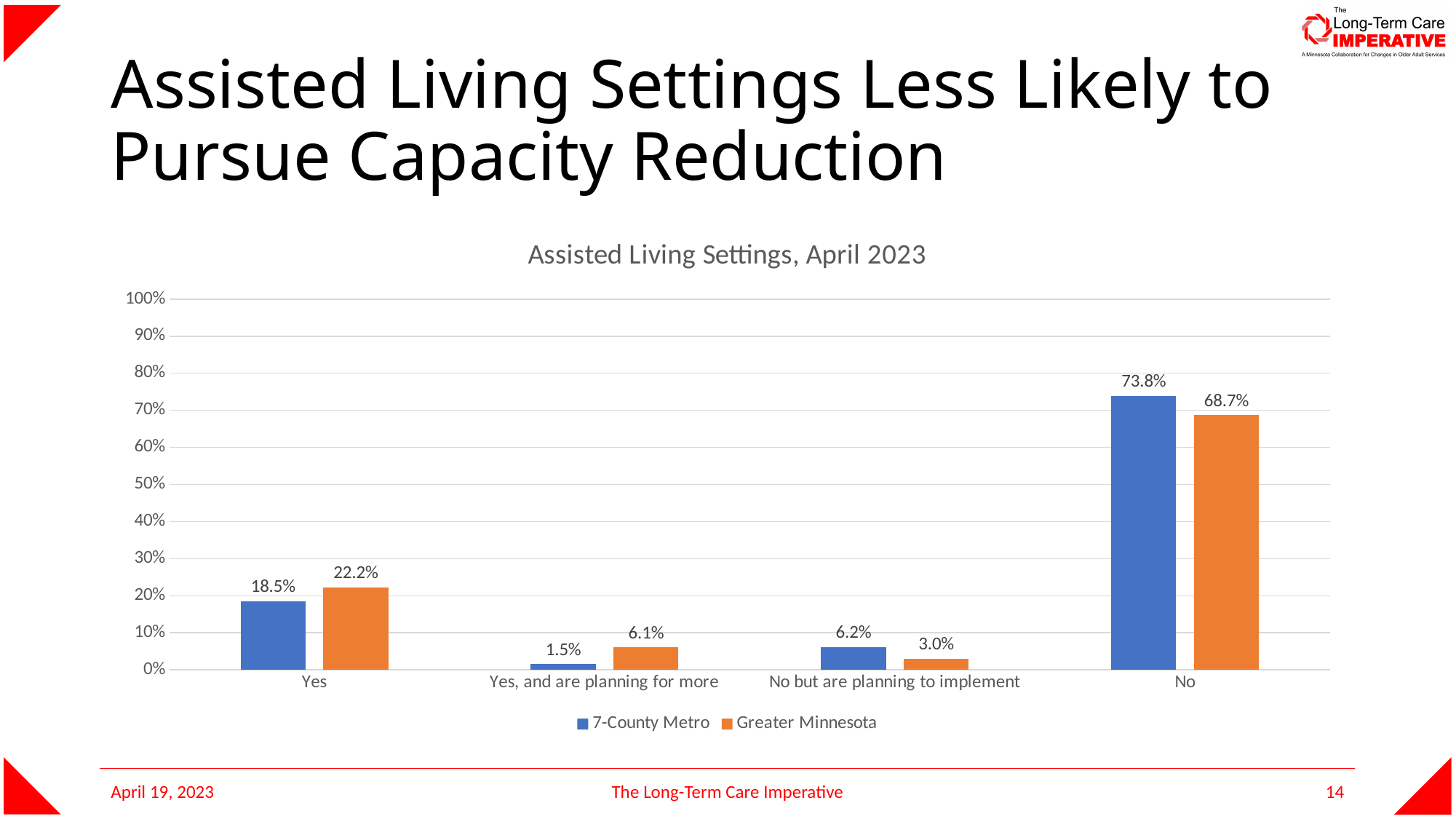
What is the value for Greater Minnesota in the "No but are planning to implement" category? 3.0% Which category has the lowest value for Greater Minnesota? No but are planning to implement What kind of chart is shown on the slide? Bar chart What is the difference between the 7-County Metro and Greater Minnesota values in the "No" category? 5.1% What is the value for 7-County Metro in the "Yes, and are planning for more" category? 1.5% Which category has the highest value for 7-County Metro? No What is the value for 7-County Metro in the "Yes" category? 18.5% In the "Yes" category, which series has the larger value, 7-County Metro or Greater Minnesota? Greater Minnesota What is the value for Greater Minnesota in the "No" category? 68.7% What is the title of the chart? Assisted Living Settings, April 2023 How many categories are shown on the x axis? 4 How many series does the legend list? 2